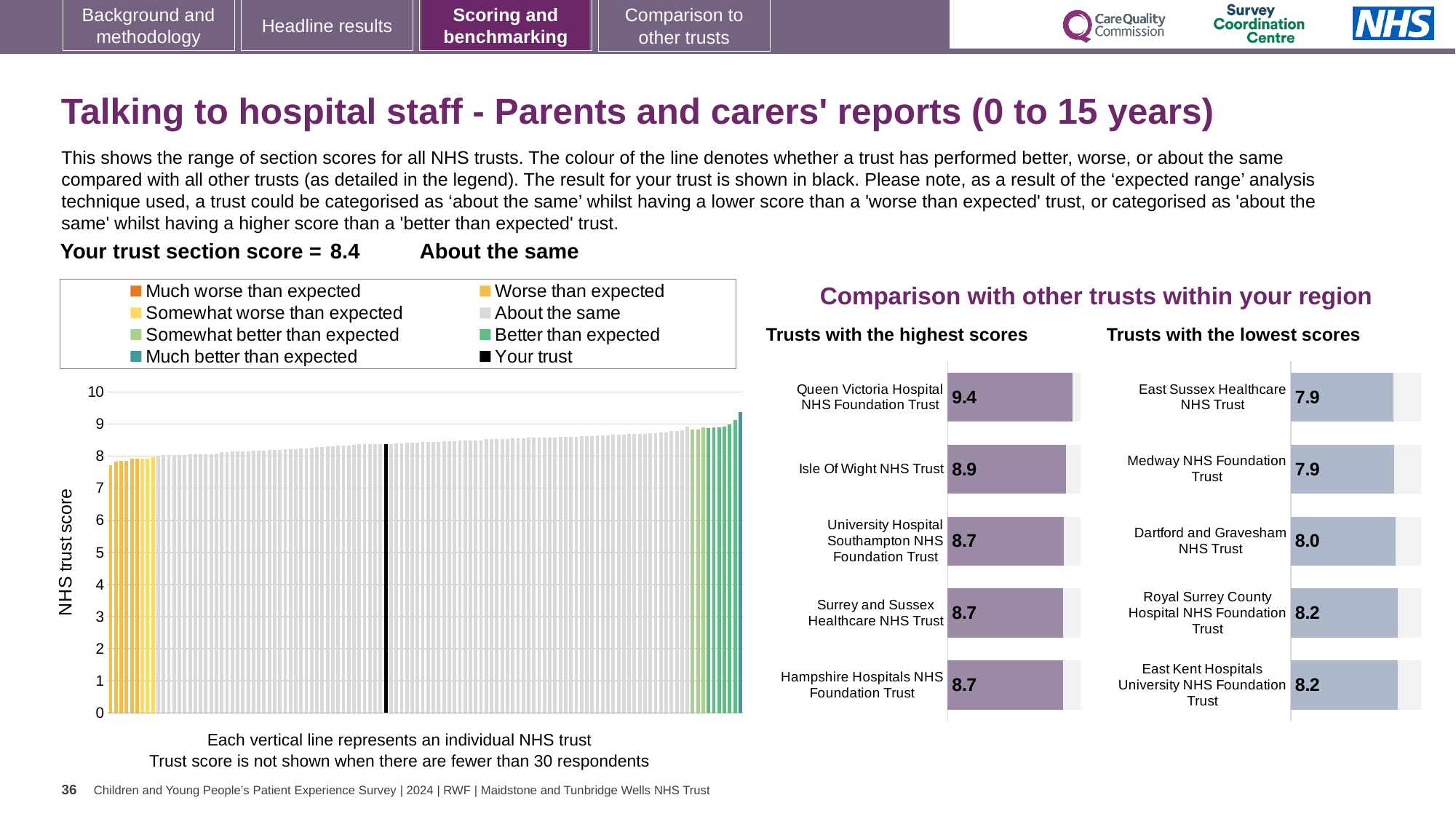
How many entries does the legend of the large chart on the left list? 8 In the 'Trusts with the highest scores' chart, what is the score for Queen Victoria Hospital NHS Foundation Trust? 9.4 In the 'Trusts with the lowest scores' chart, what is the difference between the scores of East Kent Hospitals University NHS Foundation Trust and Medway NHS Foundation Trust? 0.3 What kind of chart is the large chart on the left showing NHS trust scores? Bar chart In the large chart on the left, do the trust scores rise or fall from left to right? Rise In the large chart on the left, is the value for 'Your trust' greater or less than 8? greater In the 'Trusts with the highest scores' chart, which trust has the highest score? Queen Victoria Hospital NHS Foundation Trust In the 'Trusts with the highest scores' chart, what is the score for Isle Of Wight NHS Trust? 8.9 In the 'Trusts with the highest scores' chart, what is the difference between the scores of Queen Victoria Hospital NHS Foundation Trust and Isle Of Wight NHS Trust? 0.5 In the 'Trusts with the lowest scores' chart, which has the larger score: Dartford and Gravesham NHS Trust or Royal Surrey County Hospital NHS Foundation Trust? Royal Surrey County Hospital NHS Foundation Trust How many trusts are shown in the 'Trusts with the lowest scores' chart? 5 In the 'Trusts with the lowest scores' chart, what is the score for Dartford and Gravesham NHS Trust? 8.0